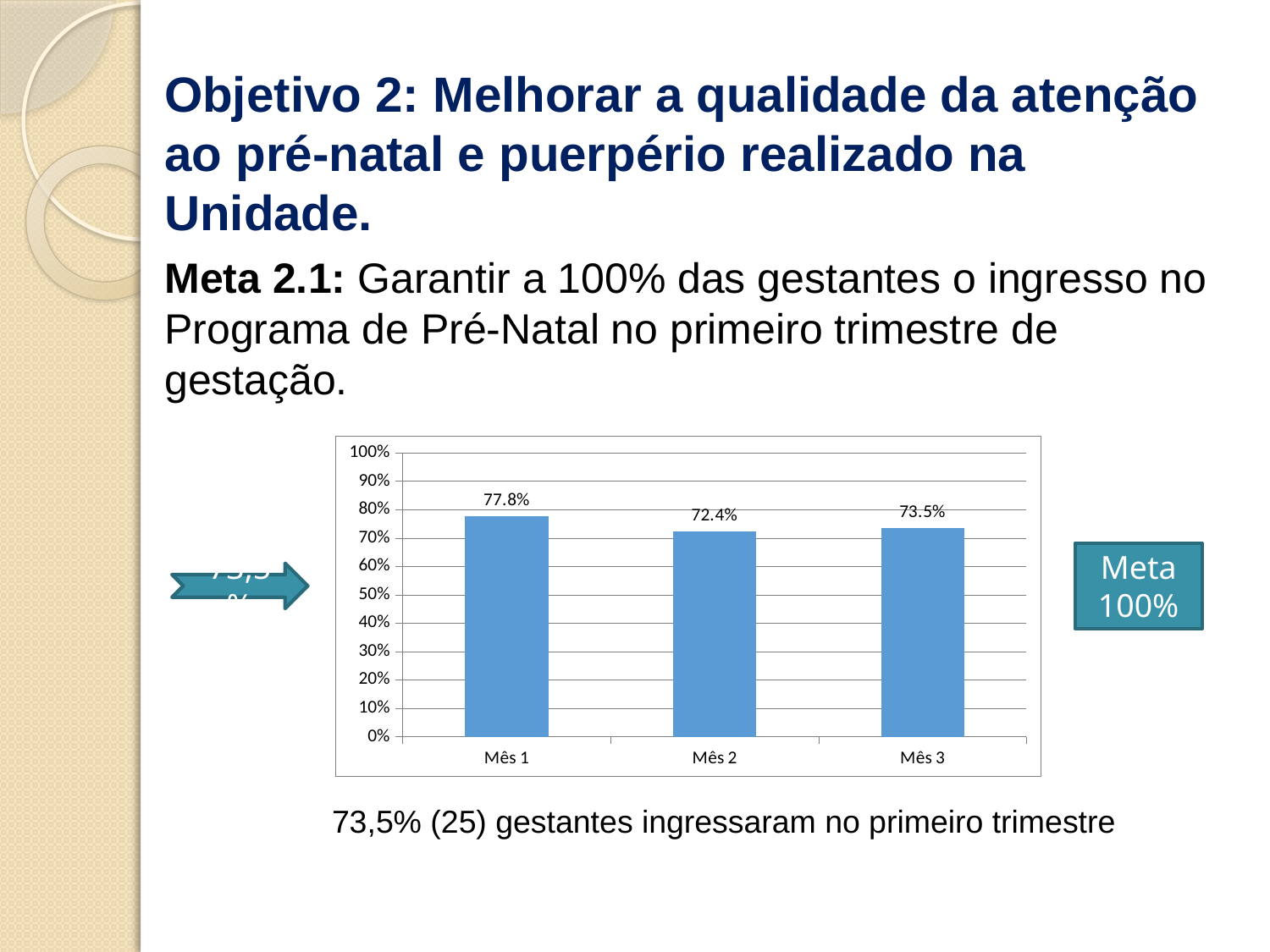
Is the value for Mês 2 greater or less than 80%? less What is the value for Mês 1? 77.8% What is the difference between the values for Mês 1 and Mês 2? 5.4% Which month has the lowest value? Mês 2 Which month has the highest value? Mês 1 What is the maximum value shown on the y axis? 100% What is the difference between the values for Mês 3 and Mês 2? 1.1% What is the value for Mês 3? 73.5% What is the value for Mês 2? 72.4% Which is larger, the value for Mês 1 or the value for Mês 3? Mês 1 How many months are shown on the x axis? 3 What kind of chart is shown on the slide? bar chart